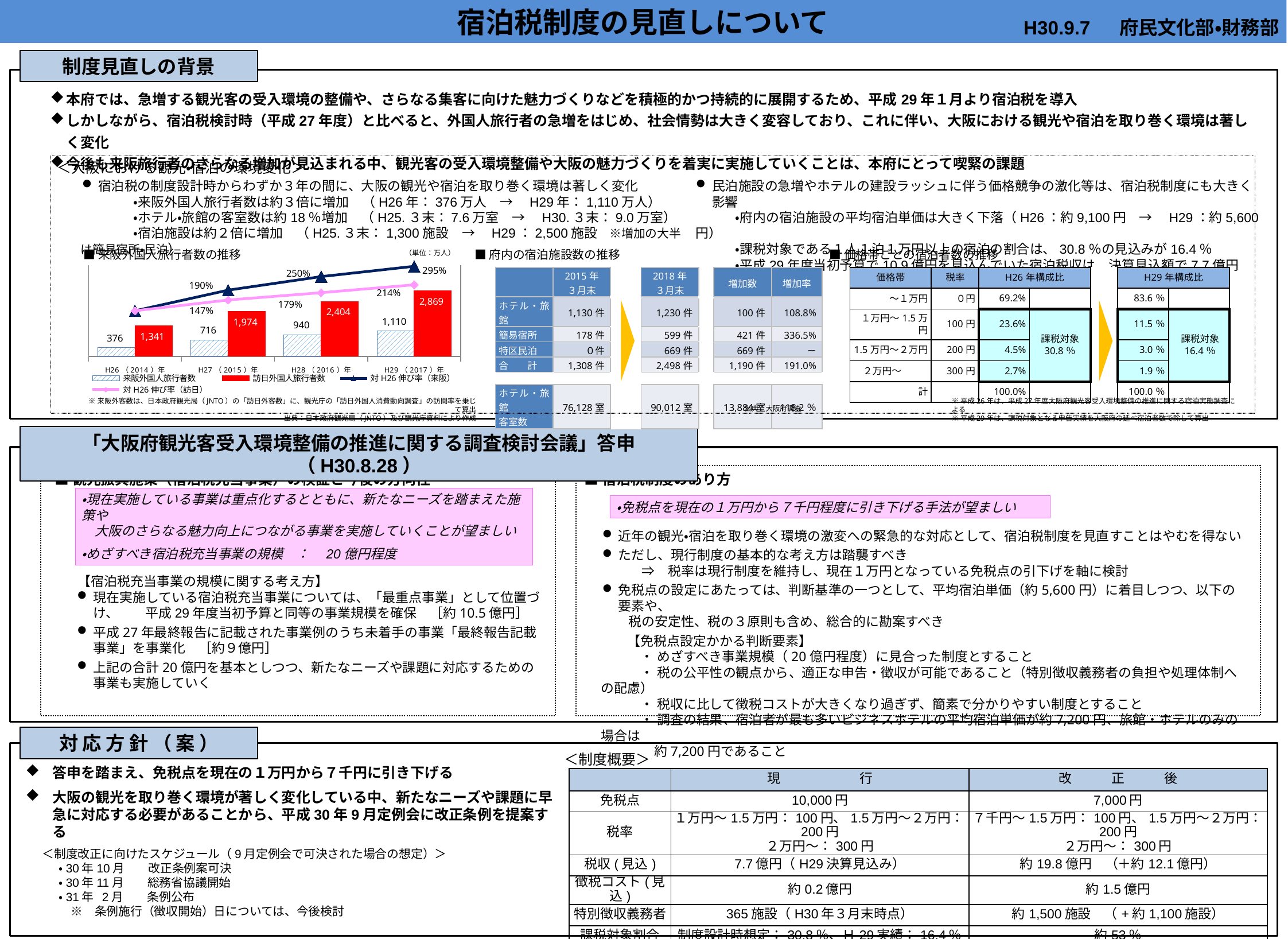
In the 来阪外国人旅行者数の推移 chart, what is the 対H26伸び率（訪日） for H29（2017）年? 214% In the 来阪外国人旅行者数の推移 chart, which year has the lowest 訪日外国人旅行者数? H26（2014）年 In the 来阪外国人旅行者数の推移 chart, what is the 対H26伸び率（来阪） for H28（2016）年? 250% In the 来阪外国人旅行者数の推移 chart, which year has the highest 来阪外国人旅行者数? H29（2017）年 Does the 来阪外国人旅行者数 rise or fall from H26（2014）年 to H29（2017）年 in the 来阪外国人旅行者数の推移 chart? rise In the 来阪外国人旅行者数の推移 chart, which is larger for H28（2016）年: 来阪外国人旅行者数 or 訪日外国人旅行者数? 訪日外国人旅行者数 How many series does the legend of the 来阪外国人旅行者数の推移 chart list? 4 In the 来阪外国人旅行者数の推移 chart, what is the value of 来阪外国人旅行者数 for H26（2014）年? 376 How many years are shown on the x axis of the 来阪外国人旅行者数の推移 chart? 4 In the 来阪外国人旅行者数の推移 chart, what is the value of 訪日外国人旅行者数 for H29（2017）年? 2,869 What unit is indicated for the values in the 来阪外国人旅行者数の推移 chart? 万人 In the 来阪外国人旅行者数の推移 chart, what is the difference between 訪日外国人旅行者数 and 来阪外国人旅行者数 for H27（2015）年? 1,258